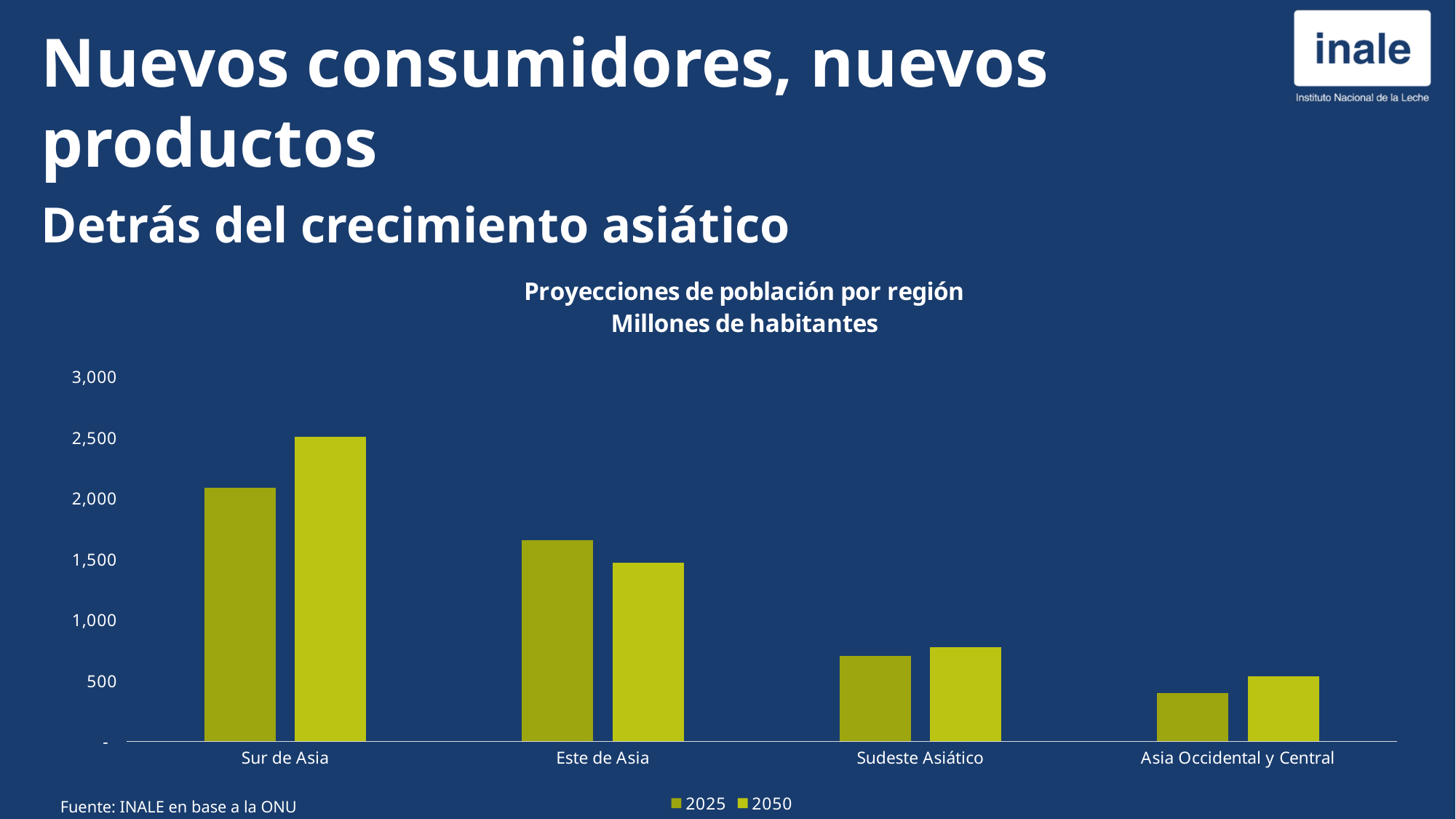
What kind of chart is shown on the slide? bar chart Which region has the lowest 2025 population value? Asia Occidental y Central How many series does the chart legend list? 2 Is the 2025 value for Asia Occidental y Central greater or less than 500? less Is the 2050 value for Sudeste Asiático greater or less than 1,000? less Is the 2050 value for Sur de Asia greater or less than 2,000? greater How many regions are shown on the x axis of the chart? 4 For Este de Asia, which is larger: the 2025 value or the 2050 value? 2025 Do the 2025 values rise or fall moving from left to right across the regions? fall For Sur de Asia, which is larger: the 2025 value or the 2050 value? 2050 Which region has the highest 2050 population projection? Sur de Asia What unit is stated in the chart title for the population projections? Millones de habitantes